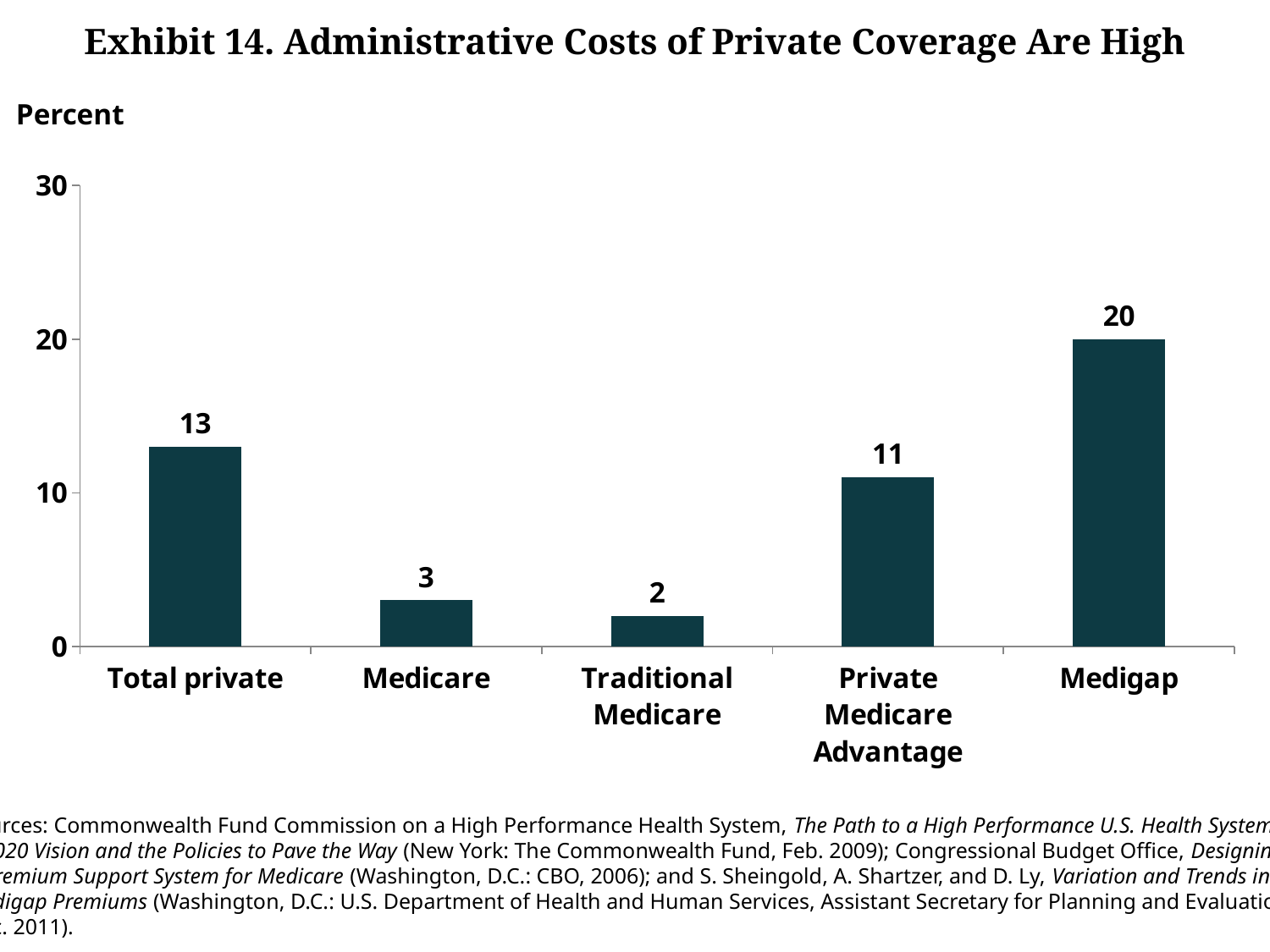
What is the value for Private Medicare Advantage? 11 What is the value for Medicare? 3 What is the difference between the values for Medigap and Total private? 7 Which category has the highest value? Medigap What is the value for Medigap? 20 Which is larger, the value for Total private or the value for Private Medicare Advantage? Total private What is the value for Traditional Medicare? 2 What is the value for Total private? 13 What is the title of the chart? Exhibit 14. Administrative Costs of Private Coverage Are High How many categories are shown on the x axis? 5 Which category has the lowest value? Traditional Medicare What kind of chart is shown on the slide? Bar chart